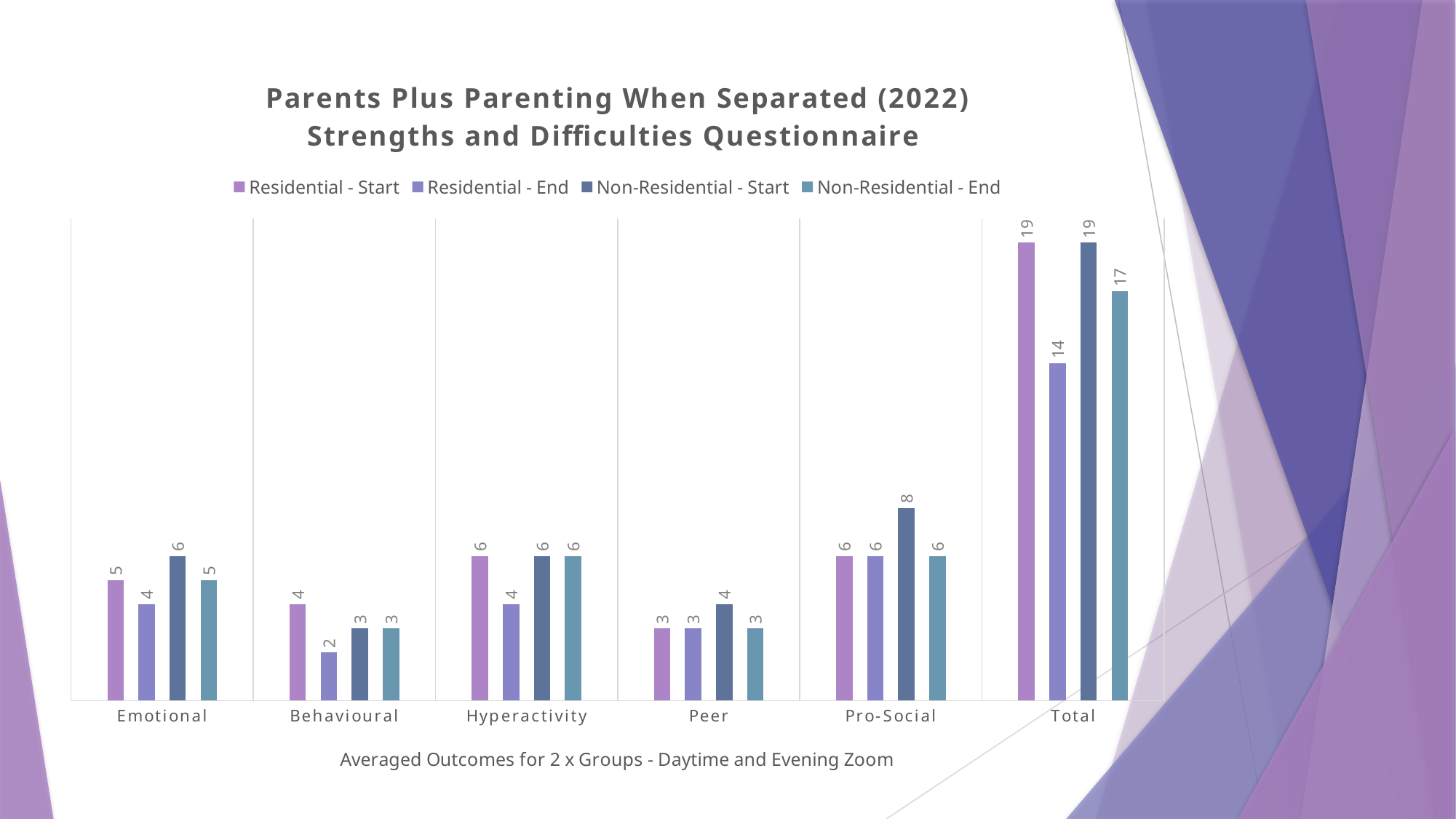
What is the Non-Residential - Start value for Pro-Social? 8 What is the Residential - Start value for Emotional? 5 How many series does the legend list? 4 What is the x-axis title of the chart? Averaged Outcomes for 2 x Groups - Daytime and Evening Zoom Which category has the lowest Residential - End value? Behavioural How many categories are shown on the x axis? 6 Which is larger for Peer: the Non-Residential - Start value or the Non-Residential - End value? Non-Residential - Start What is the Non-Residential - End value for Total? 17 What is the difference between the Residential - Start and Residential - End values for Total? 5 Which category has the highest Residential - End value? Total What is the Residential - End value for Behavioural? 2 What kind of chart is shown on the slide? Bar chart